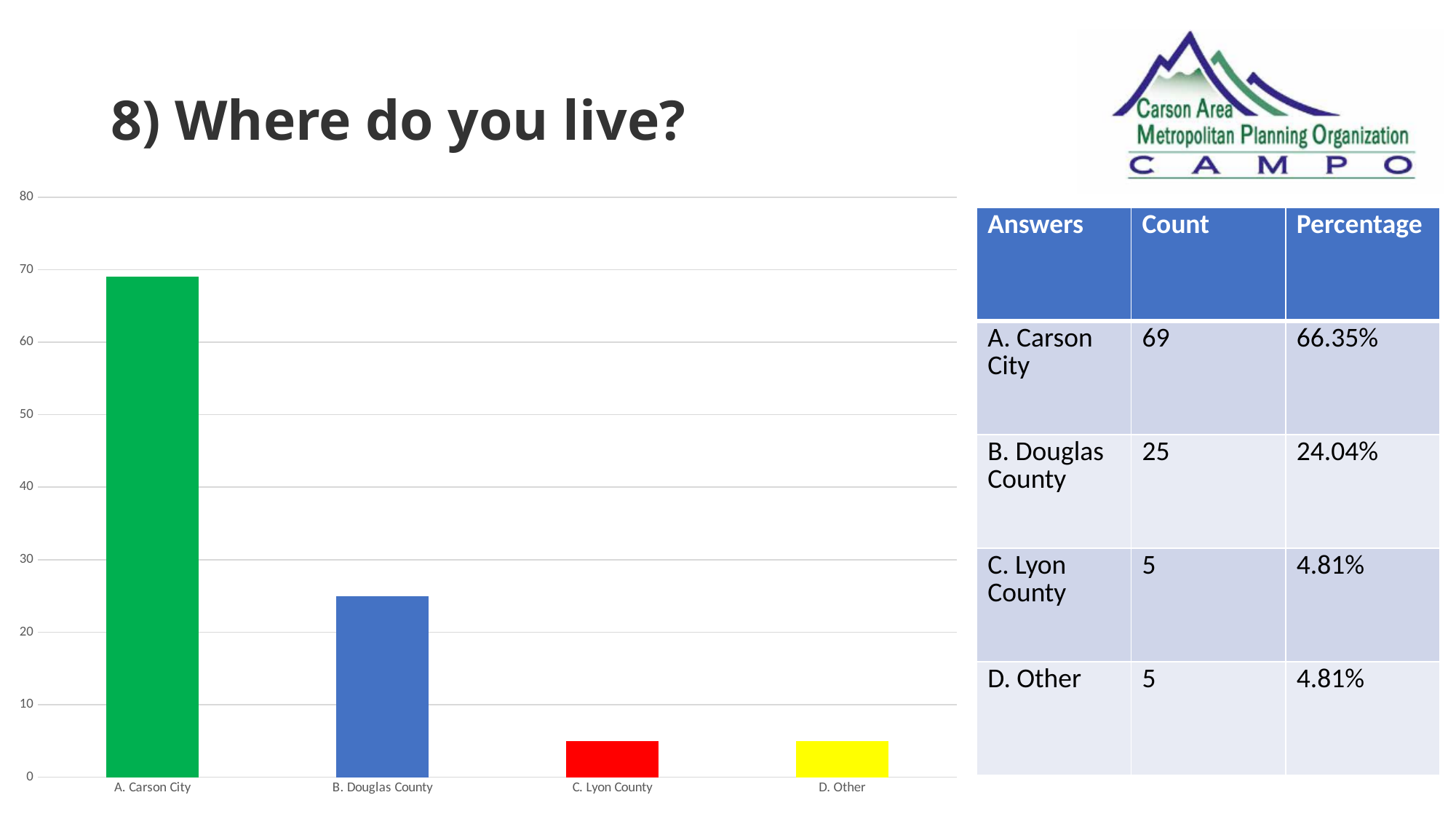
What is the difference in count between A. Carson City and B. Douglas County? 44 What is the percentage for A. Carson City? 66.35% How many categories does the bar chart show? 4 What kind of chart is shown on the slide? bar chart Which is larger, the count for B. Douglas County or the count for D. Other? B. Douglas County What colour is the bar for C. Lyon County? red What is the count for B. Douglas County? 25 What is the percentage for B. Douglas County? 24.04% Is the value for A. Carson City greater or less than 60? greater What is the count for A. Carson City? 69 Which category has the highest value in the bar chart? A. Carson City What is the count for C. Lyon County? 5